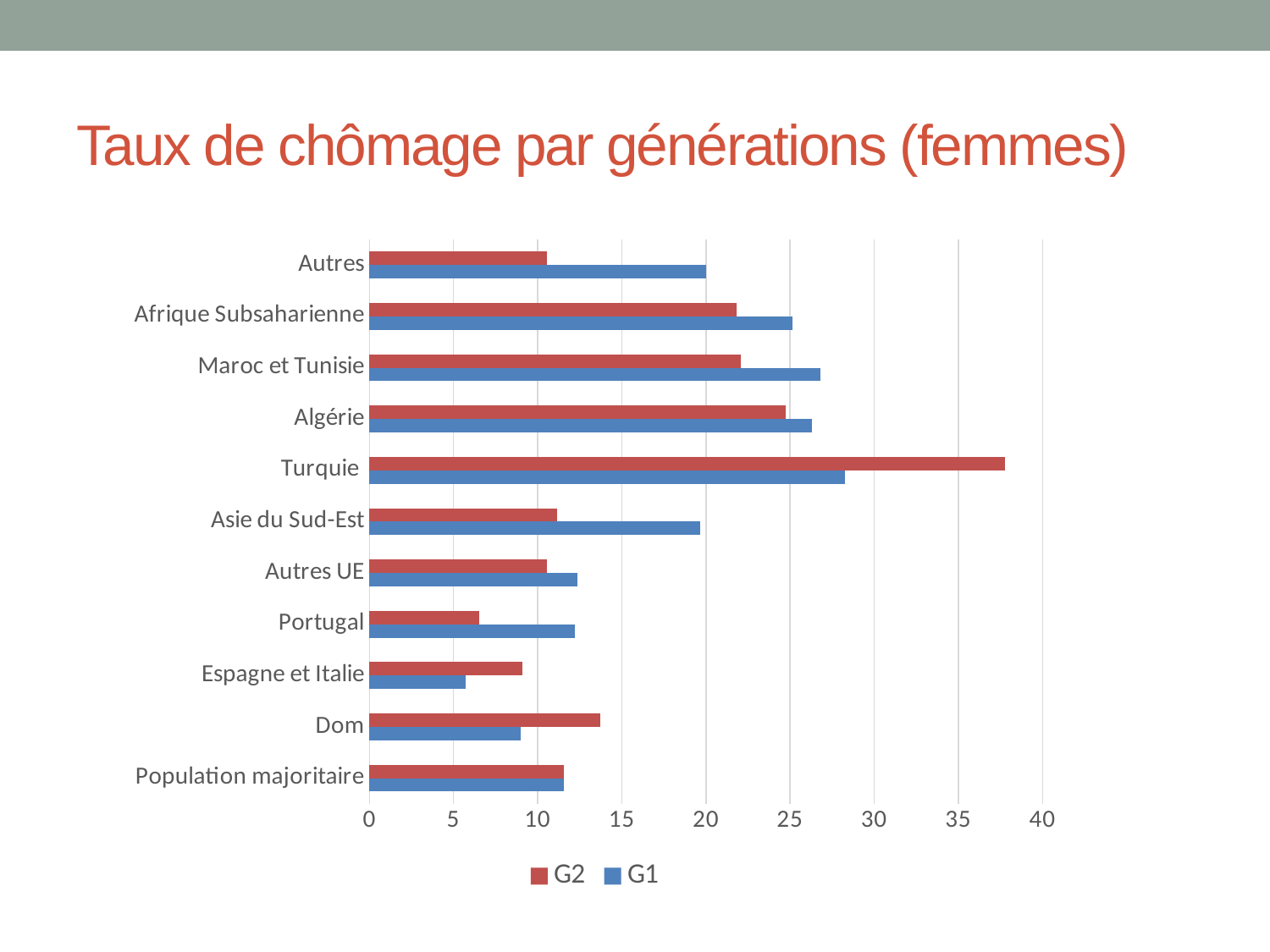
How many categories are shown on the chart? 11 Which category has the lowest G2 value? Portugal Which category has the highest G1 value? Turquie Which category has the lowest G1 value? Espagne et Italie Is the G2 value for Turquie greater or less than 35? greater What kind of chart is shown on the slide? bar chart Which category has the highest G2 value? Turquie Is the G1 value for Portugal greater or less than 15? less For Dom, which series has the larger value, G1 or G2? G2 What is the title of the chart? Taux de chômage par générations (femmes) How many series does the legend list? 2 For Asie du Sud-Est, which series has the larger value, G1 or G2? G1